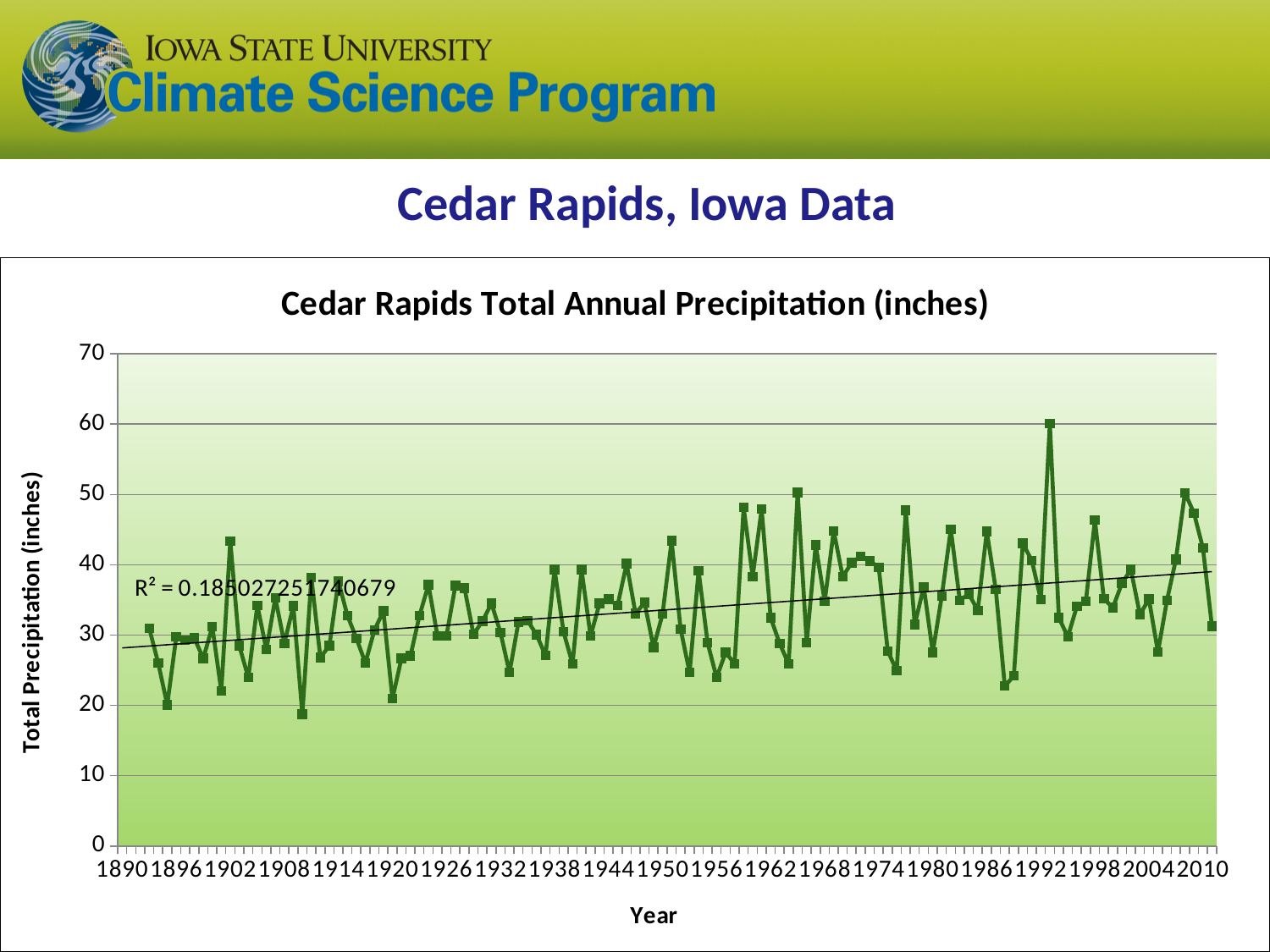
What is the title of the chart? Cedar Rapids Total Annual Precipitation (inches) Is the value for 1962 greater or less than 40 inches? less What kind of chart is shown on the slide? Line chart Is the peak value near 1993 greater or less than 50 inches? greater According to the trend line, do precipitation values generally rise or fall from 1890 to 2010? Rise What is the label of the vertical axis? Total Precipitation (inches) Around which year does the chart show the highest total annual precipitation? 1993 What is the highest value shown on the vertical axis? 70 What R² value is printed on the chart? R² = 0.185027251740679 Which is larger, the precipitation value for 1993 or for 1910? 1993